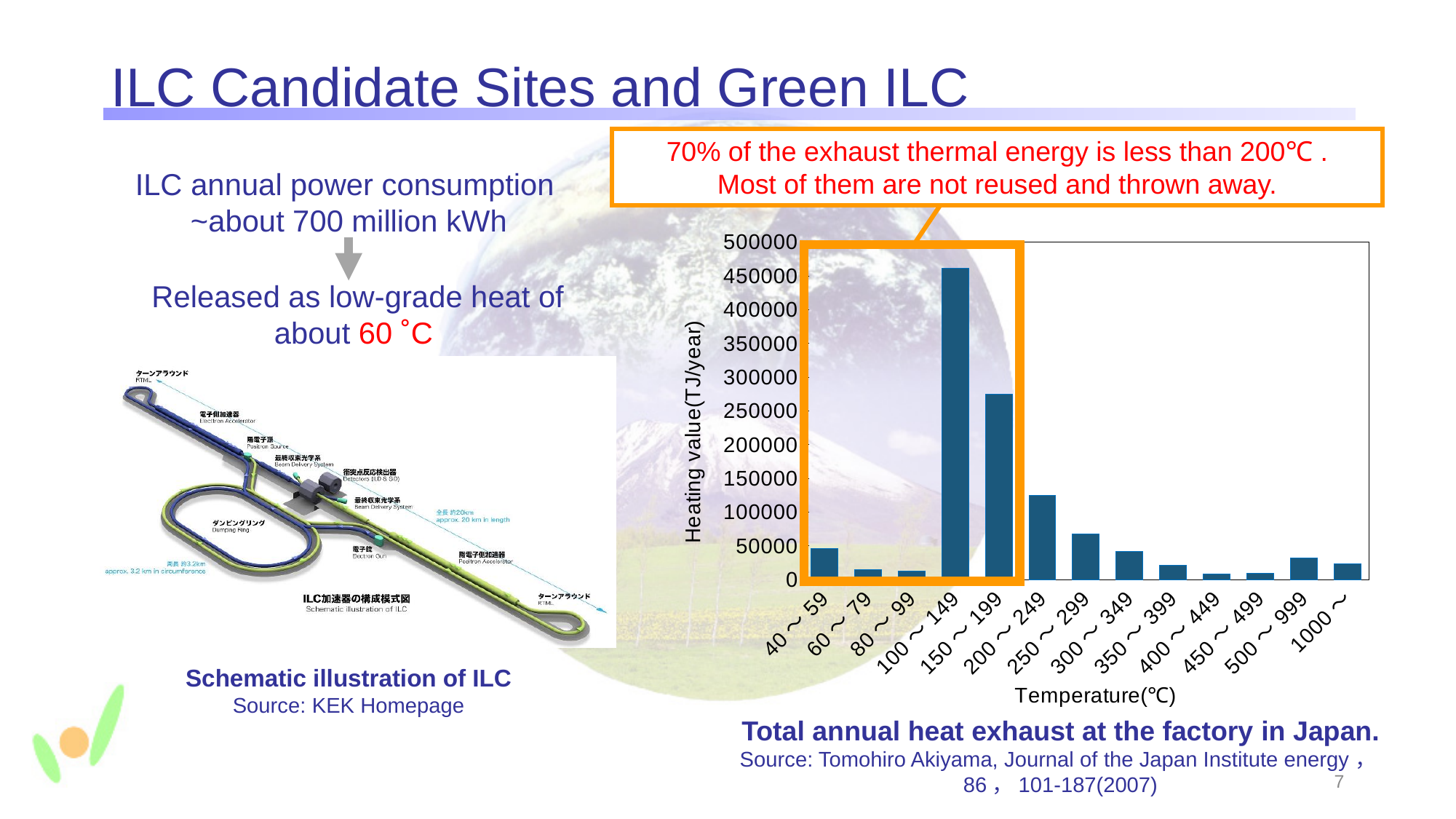
Which has the larger heating value, the 40～59 range or the 60～79 range? 40～59 Is the heating value for the 100～149 temperature range greater or less than 400000? greater Is the heating value for the 200～249 temperature range greater or less than 100000? greater Is the heating value for the 40～59 temperature range greater or less than 50000? less Which has the larger heating value, the 150～199 range or the 200～249 range? 150～199 What kind of chart is shown on the slide? bar chart What is the title given below the chart? Total annual heat exhaust at the factory in Japan. How many temperature categories are plotted on the x axis of the chart? 13 Which temperature range has the highest heating value in the chart? 100～149 What is the label of the vertical axis of the chart? Heating value(TJ/year)